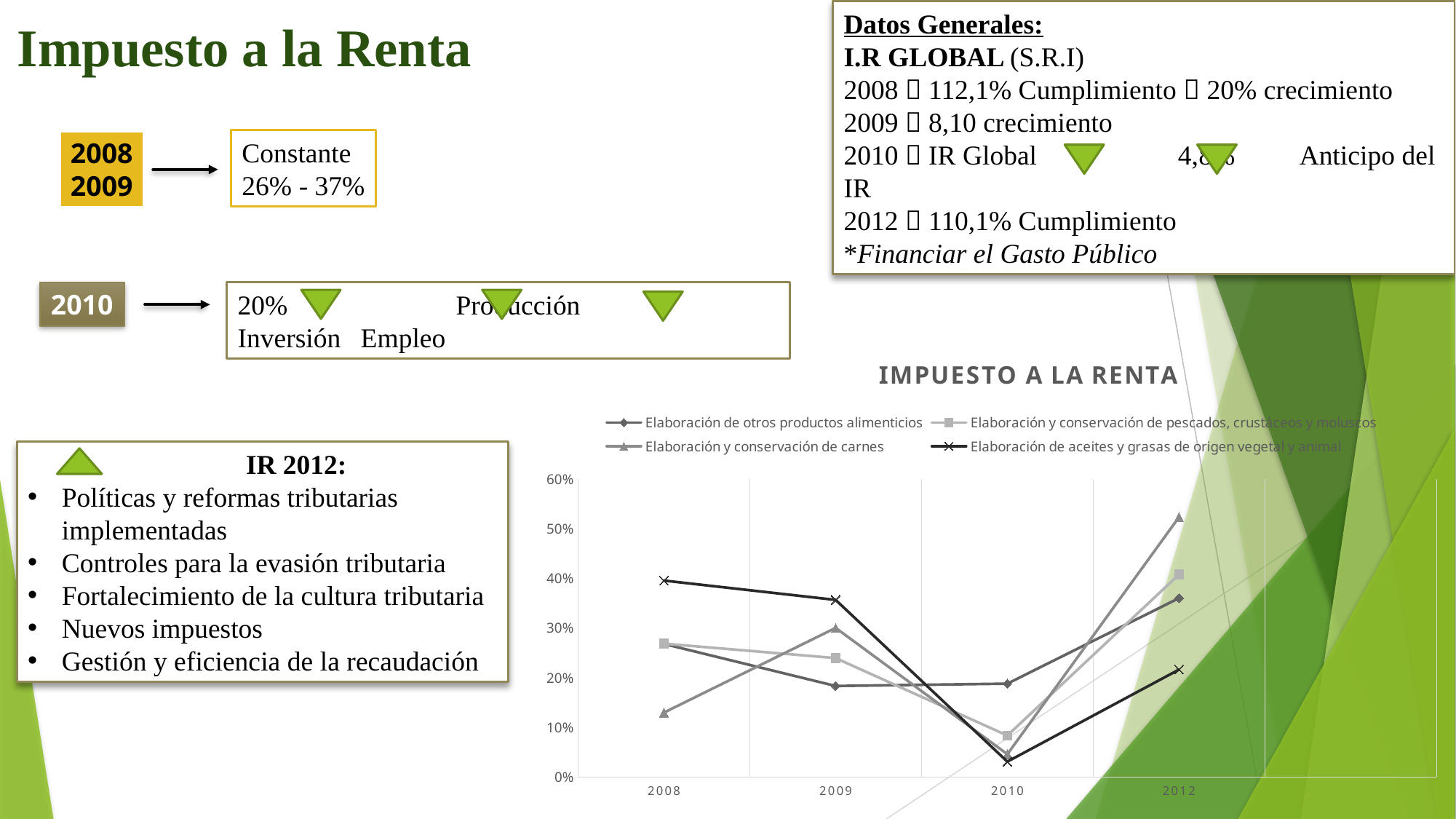
In the IMPUESTO A LA RENTA chart, which series has the highest value in 2008? Elaboración de aceites y grasas de origen vegetal y animal What is the title of the line chart on the slide? IMPUESTO A LA RENTA In the IMPUESTO A LA RENTA chart, is the 2012 value for Elaboración y conservación de carnes greater or less than 50%? greater In the IMPUESTO A LA RENTA chart, which series has the highest value in 2012? Elaboración y conservación de carnes In the IMPUESTO A LA RENTA chart, which series has the lowest value in 2008? Elaboración y conservación de carnes How many series does the legend of the IMPUESTO A LA RENTA chart list? 4 In the IMPUESTO A LA RENTA chart, which is larger in 2009: Elaboración y conservación de carnes or Elaboración de otros productos alimenticios? Elaboración y conservación de carnes In the IMPUESTO A LA RENTA chart, is the 2010 value for Elaboración de aceites y grasas de origen vegetal y animal greater or less than 10%? less What kind of chart is shown under the title IMPUESTO A LA RENTA? line chart In the IMPUESTO A LA RENTA chart, does the value for Elaboración de aceites y grasas de origen vegetal y animal rise or fall from 2008 to 2010? fall How many years are shown on the x axis of the IMPUESTO A LA RENTA chart? 4